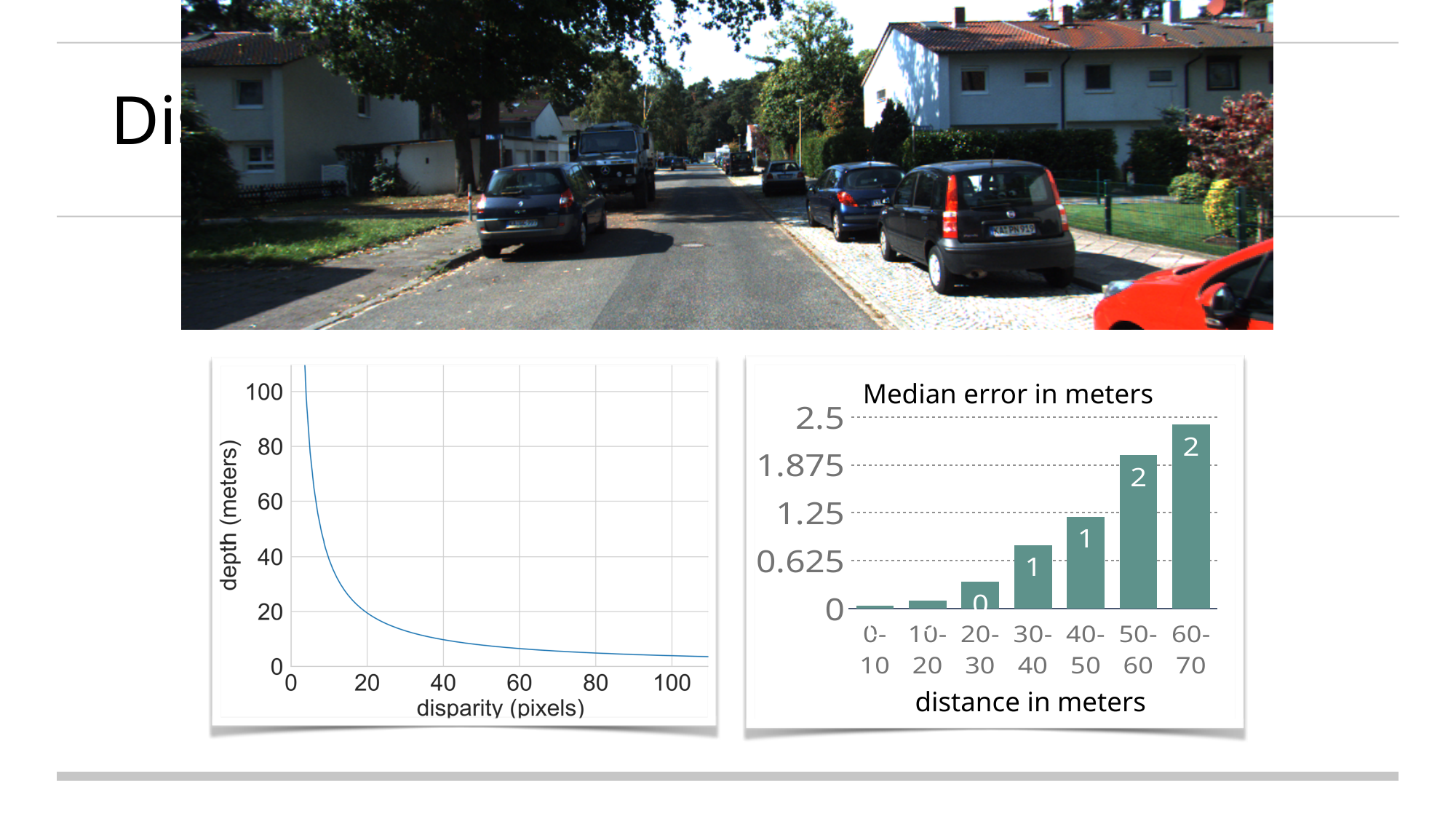
In the 'Median error in meters' chart, which distance range has the highest median error? 60-70 In the 'Median error in meters' chart, is the value for 20-30 greater or less than 0.625? less In the 'Median error in meters' chart, which is larger, the median error for 30-40 or for 50-60? 50-60 In the 'Median error in meters' chart, how many distance ranges are shown on the x axis? 7 What kind of chart is the 'Median error in meters' chart on the right? bar chart In the depth versus disparity chart on the left, does depth rise or fall as disparity increases? fall In the 'Median error in meters' chart, what data label is printed on the bar for 30-40? 1 What kind of chart is the chart on the left showing depth against disparity? line chart In the 'Median error in meters' chart, do the values rise or fall as distance increases along the x axis? rise In the 'Median error in meters' chart, which distance range has the lowest median error? 0-10 In the 'Median error in meters' chart, what data label is printed on the bar for 60-70? 2 In the 'Median error in meters' chart, is the value for 60-70 greater or less than 1.875? greater